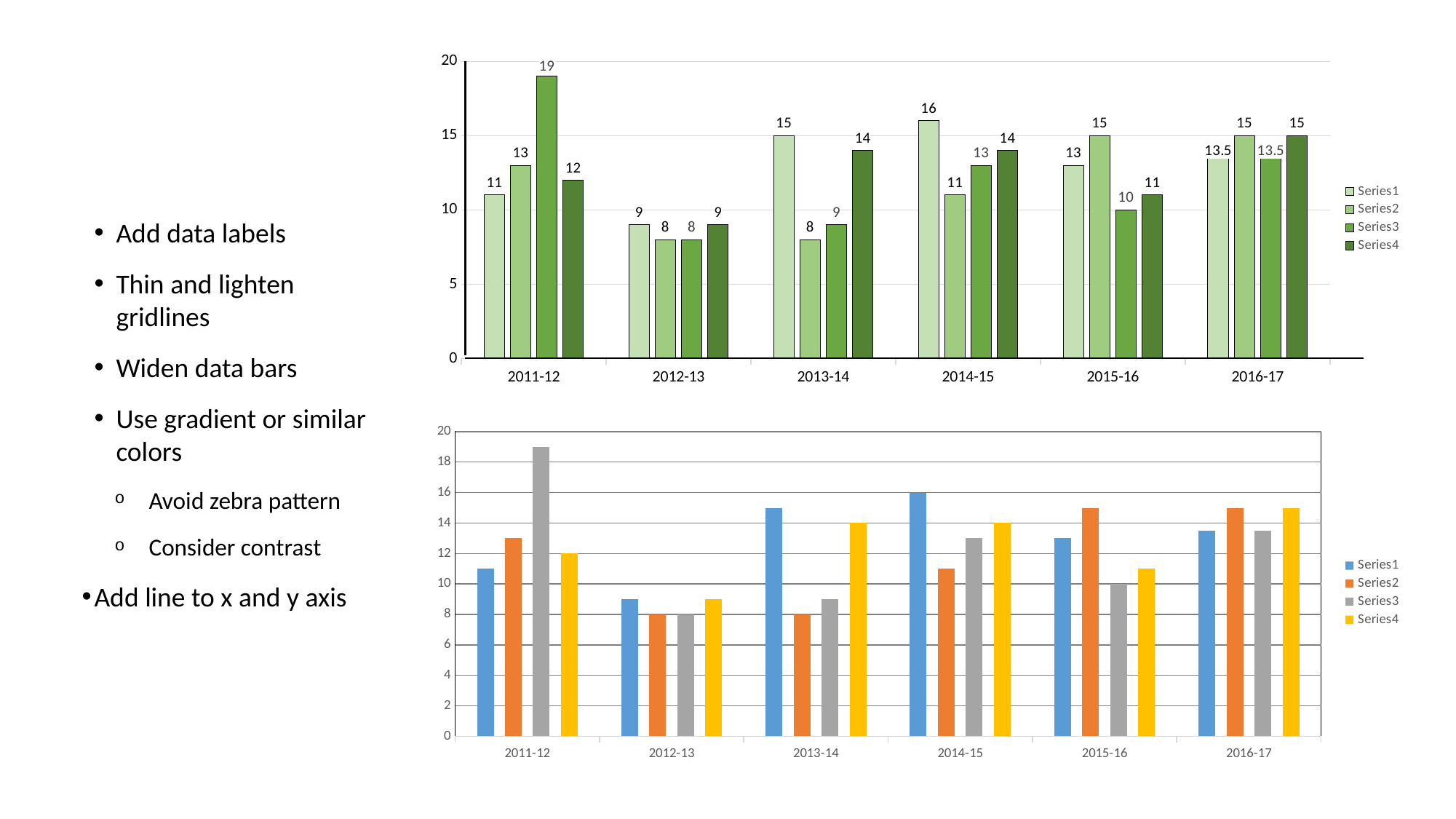
In the top chart, what is the value of Series3 for 2011-12? 19 In the top chart, which is larger for 2015-16: Series2 or Series4? Series2 In the top chart, what is the value of Series4 for 2014-15? 14 In the bottom chart, is the value for Series3 in 2011-12 greater or less than 18? greater How many categories are shown on the x axis of the top chart? 6 In the top chart, what is the value of Series1 for 2016-17? 13.5 How many series does the legend of the bottom chart list? 4 In the top chart, what is the difference between the Series3 value for 2011-12 and the Series3 value for 2012-13? 11 What kind of chart is the bottom chart? bar chart In the top chart, which category has the highest Series1 value? 2014-15 In the top chart, which category has the lowest Series3 value? 2012-13 In the bottom chart, is the value for Series2 in 2012-13 greater or less than 10? less